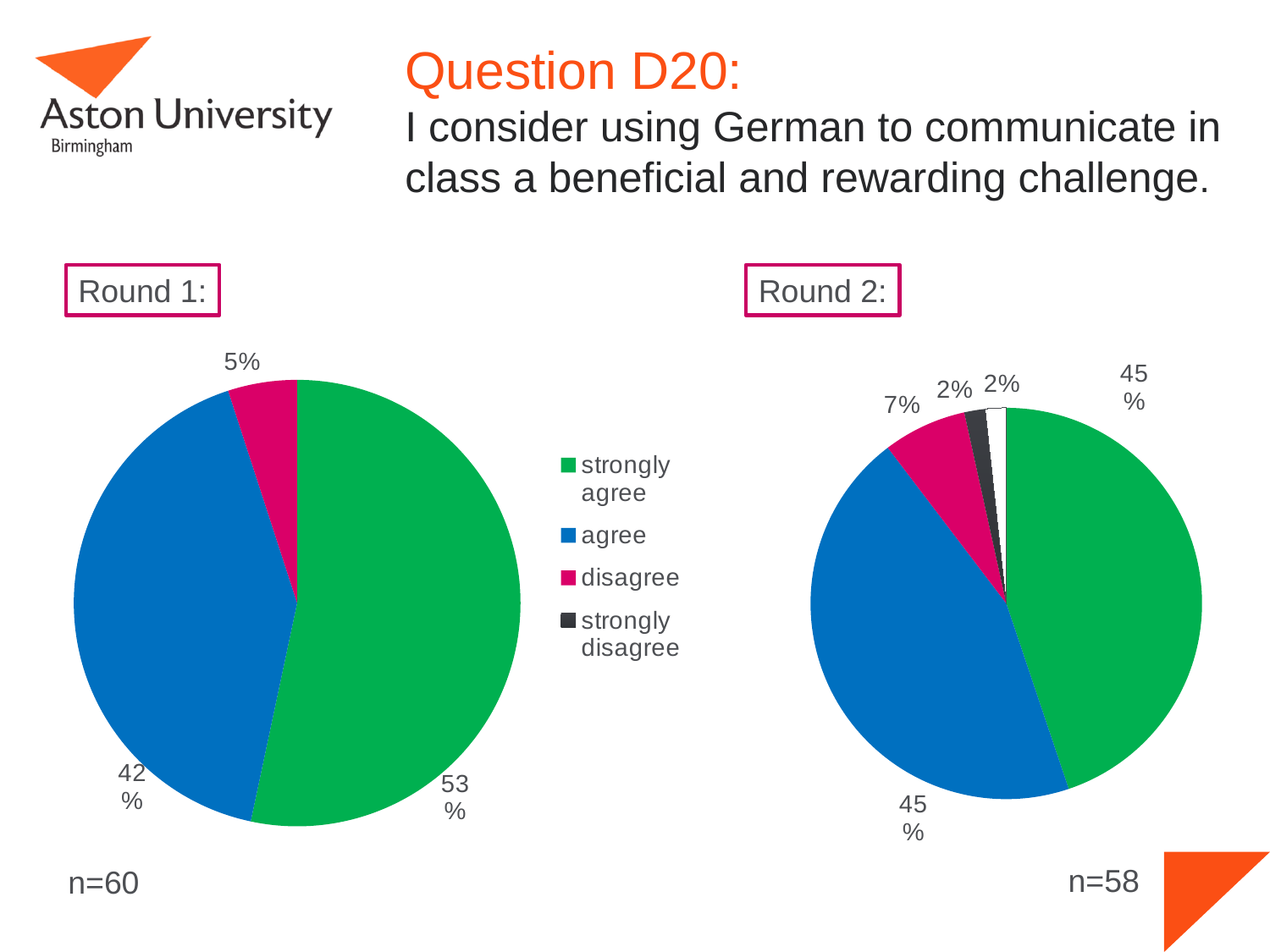
How many response categories does the legend list? 4 In the Round 1 pie chart, what share of respondents chose 'strongly agree'? 53% What type of chart is used for Round 1 and Round 2? Pie chart In the Round 2 pie chart, what share of respondents chose 'strongly disagree'? 2% In the Round 1 pie chart, what share of respondents chose 'agree'? 42% In the Round 1 pie chart, what share of respondents chose 'disagree'? 5% In the Round 1 pie chart, which response category has the largest share? strongly agree In the Round 1 pie chart, what is the difference in percentage points between 'strongly agree' and 'agree'? 11 percentage points Is the 'strongly agree' share larger in the Round 1 pie chart or the Round 2 pie chart? Round 1 In the Round 1 pie chart, which response category has the smallest share? disagree In the Round 2 pie chart, what share of respondents chose 'disagree'? 7% What is the sample size (n) shown for the Round 2 pie chart? n=58